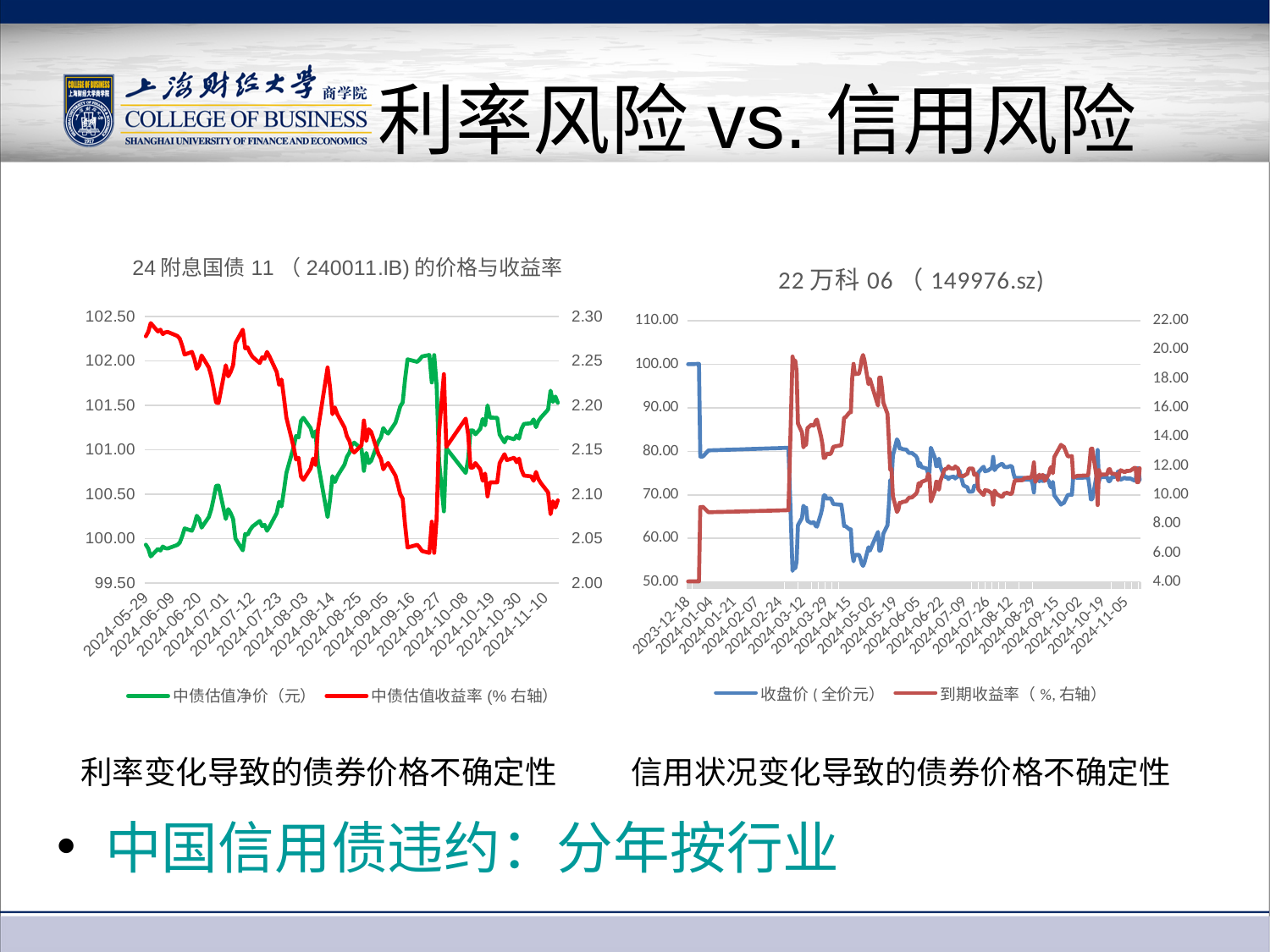
In the right chart (22 万科 06), is the 到期收益率 value at 2023-12-18 greater or less than 6.00? less In the left chart (24 附息国债 11), is the 中债估值净价 value at 2024-05-29 greater or less than 100.50? less How many series does the legend of the right chart (22 万科 06) list? 2 In the right chart (22 万科 06), which series is plotted on the right axis? 到期收益率（%, 右轴） In the left chart (24 附息国债 11), which series is drawn in green? 中债估值净价（元） In the right chart (22 万科 06), does the 收盘价 series rise or fall overall from 2023-12-18 to 2024-11-05? fall In the right chart (22 万科 06), is the 收盘价 value at 2023-12-18 greater or less than 90.00? greater What kind of chart is the left chart titled 24 附息国债 11 （240011.IB) 的价格与收益率? line chart In the left chart (24 附息国债 11), does the 中债估值收益率 series rise or fall overall from 2024-05-29 to 2024-11-10? fall What kind of chart is the right chart titled 22 万科 06 （149976.sz)? line chart In the left chart (24 附息国债 11), does the 中债估值净价 series rise or fall overall from 2024-05-29 to 2024-11-10? rise How many series does the legend of the left chart (24 附息国债 11) list? 2